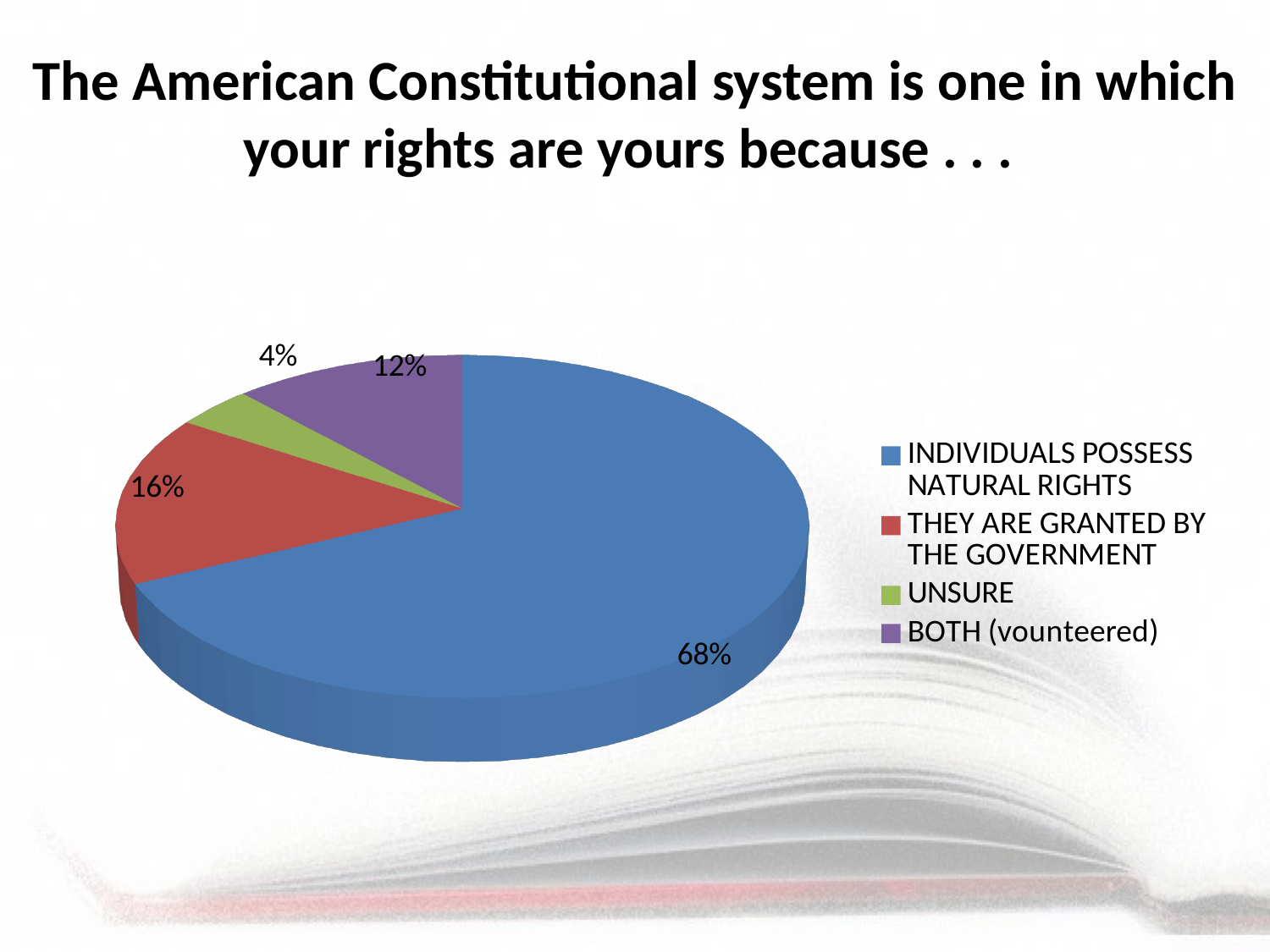
What colour is the slice for THEY ARE GRANTED BY THE GOVERNMENT? red What kind of chart is shown on the slide? pie chart What is the difference in percentage points between THEY ARE GRANTED BY THE GOVERNMENT and BOTH (vounteered)? 4 What share of the pie is labelled UNSURE? 4% Which category has the smallest slice of the pie? UNSURE Which category has the largest slice of the pie? INDIVIDUALS POSSESS NATURAL RIGHTS How many entries does the legend list? 4 What share of the pie is labelled THEY ARE GRANTED BY THE GOVERNMENT? 16% What share of the pie is labelled BOTH (vounteered)? 12% Which is larger: the share for BOTH (vounteered) or the share for UNSURE? BOTH (vounteered) How many slices does the pie chart have? 4